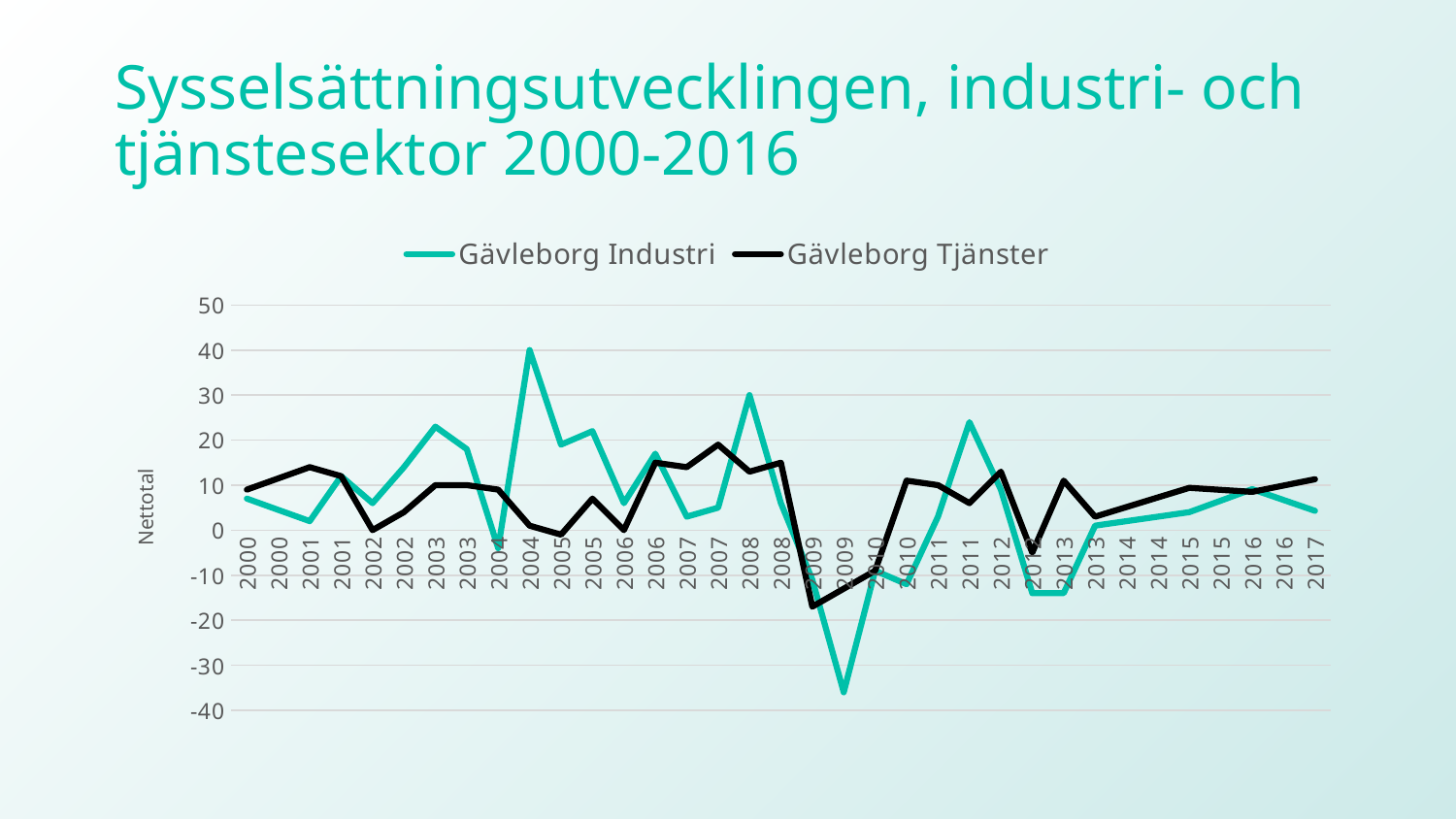
At the peak in 2004, which series has the higher value, Gävleborg Industri or Gävleborg Tjänster? Gävleborg Industri What are the two series named in the legend? Gävleborg Industri and Gävleborg Tjänster Is the lowest value of Gävleborg Industri in 2009 greater or less than -30? less Is the peak value of Gävleborg Industri in 2004 greater or less than 30? greater What is the label on the vertical axis? Nettotal Is the lowest value of Gävleborg Tjänster in 2009 greater or less than -10? less Does the Gävleborg Tjänster line generally rise or fall from 2013 to 2017? rise In which year does the Gävleborg Tjänster line reach its lowest value? 2009 In which year does the Gävleborg Industri line reach its lowest value? 2009 In which year does the Gävleborg Industri line reach its highest value? 2004 How many series does the legend list? 2 What kind of chart is shown on the slide? line chart